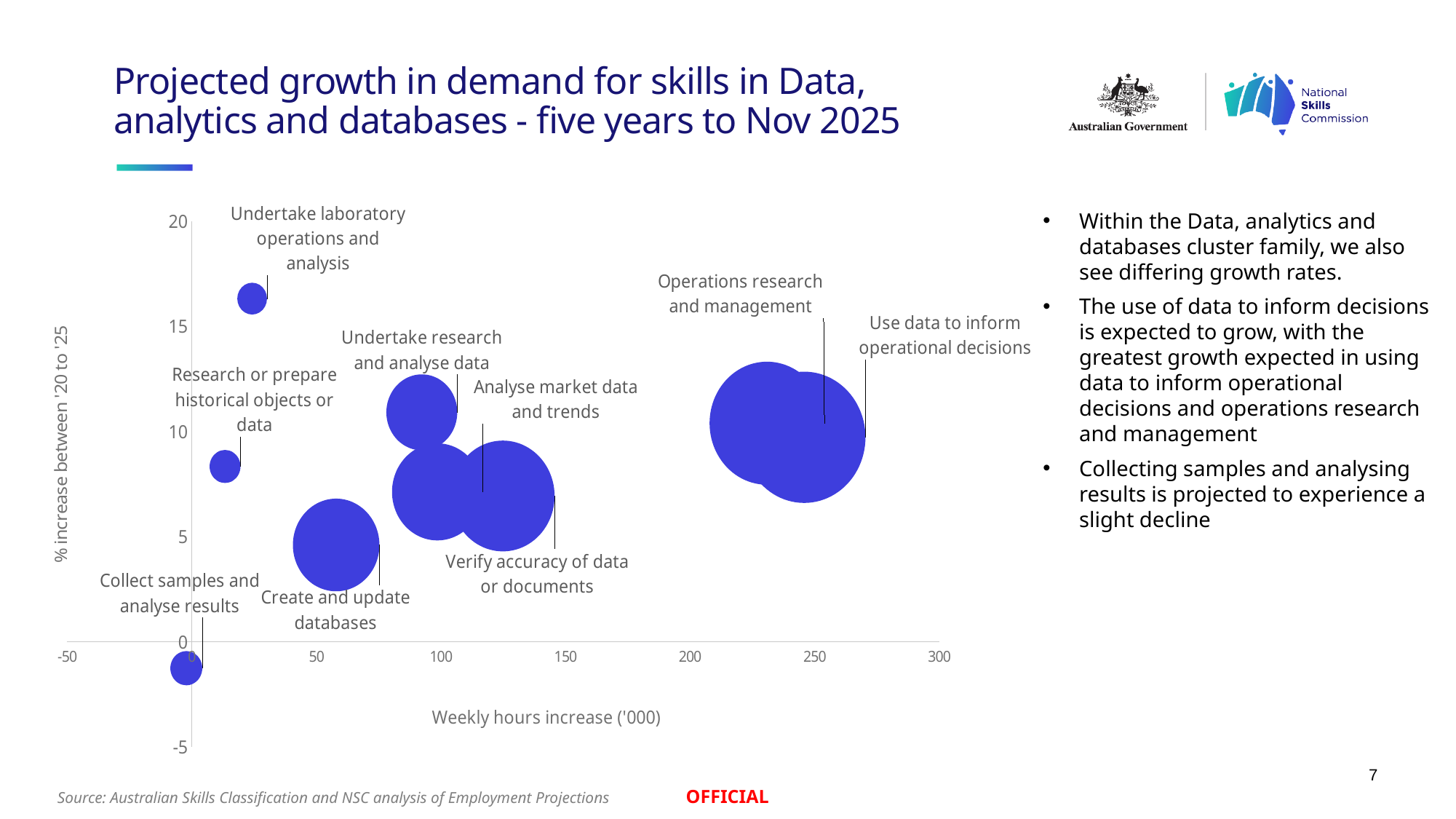
Is the % increase for Undertake laboratory operations and analysis greater or less than 15? greater What kind of chart is shown on the slide? Bubble chart Is the weekly hours increase for Operations research and management greater or less than 200? greater Which skill has the lowest % increase between '20 and '25? Collect samples and analyse results Is the % increase for Collect samples and analyse results greater or less than 0? less What is the label of the x axis? Weekly hours increase ('000) Which skill has the largest weekly hours increase ('000)? Use data to inform operational decisions Which has the larger weekly hours increase: Verify accuracy of data or documents or Create and update databases? Verify accuracy of data or documents What is the label of the y axis? % increase between '20 to '25 Which skill has the highest % increase between '20 and '25? Undertake laboratory operations and analysis How many skills (bubbles) are plotted on the chart? 9